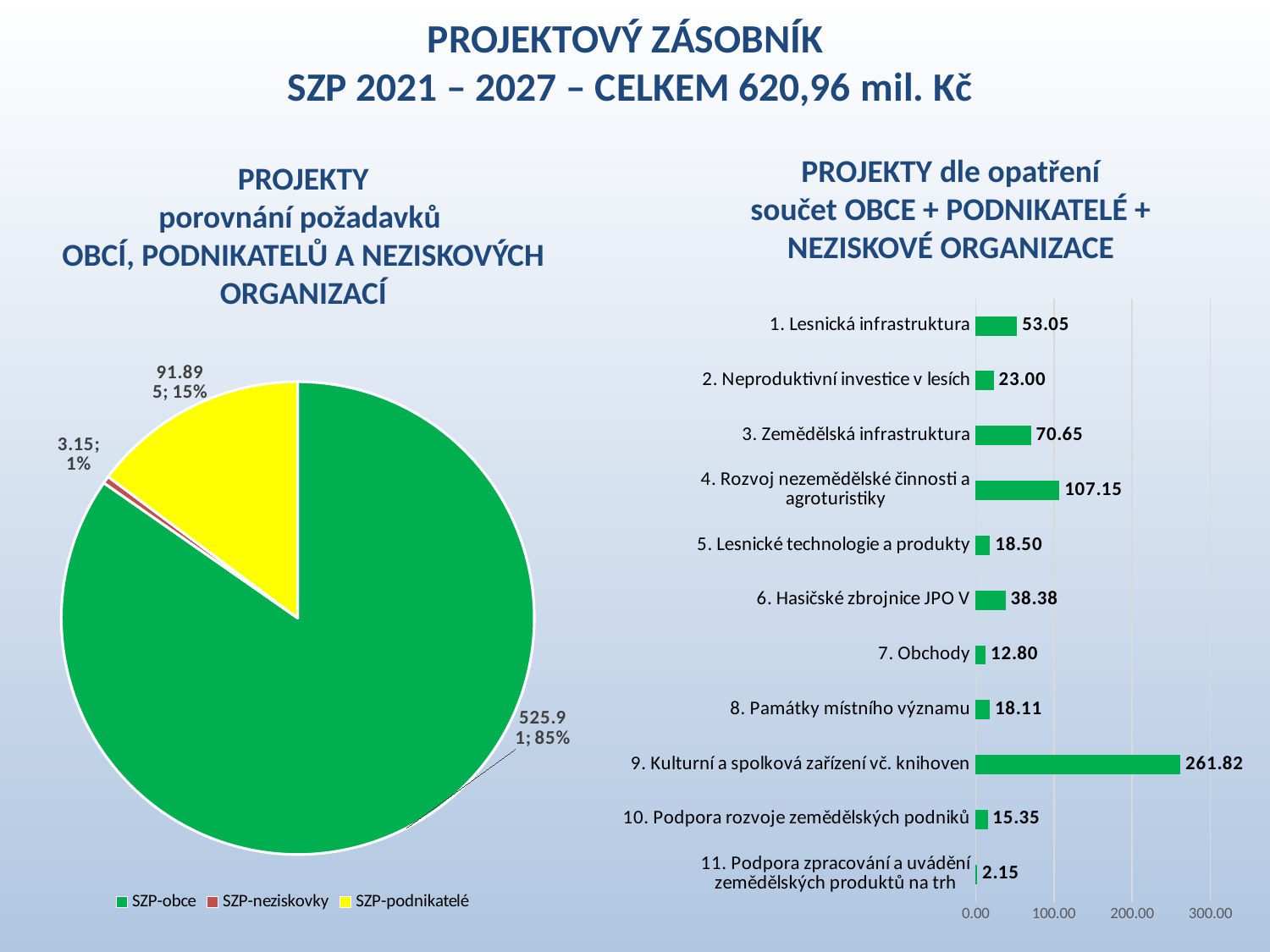
In the bar chart on the right, which category has the highest value? 9. Kulturní a spolková zařízení vč. knihoven In the pie chart on the left, what is the value for SZP-neziskovky? 3.15 In the bar chart on the right, what is the value for 4. Rozvoj nezemědělské činnosti a agroturistiky? 107.15 In the bar chart on the right, which is larger: the value for 1. Lesnická infrastruktura or the value for 7. Obchody? 1. Lesnická infrastruktura In the bar chart on the right, which category has the lowest value? 11. Podpora zpracování a uvádění zemědělských produktů na trh In the bar chart on the right, what is the value for 6. Hasičské zbrojnice JPO V? 38.38 In the bar chart on the right, what is the difference between the values for 3. Zemědělská infrastruktura and 2. Neproduktivní investice v lesích? 47.65 In the bar chart on the right, what is the value for 9. Kulturní a spolková zařízení vč. knihoven? 261.82 In the pie chart on the left, what share of the pie does SZP-obce have? 85% How many series does the legend of the pie chart on the left list? 3 What kind of chart is the chart on the right of the slide? Bar chart How many categories are shown in the bar chart on the right? 11